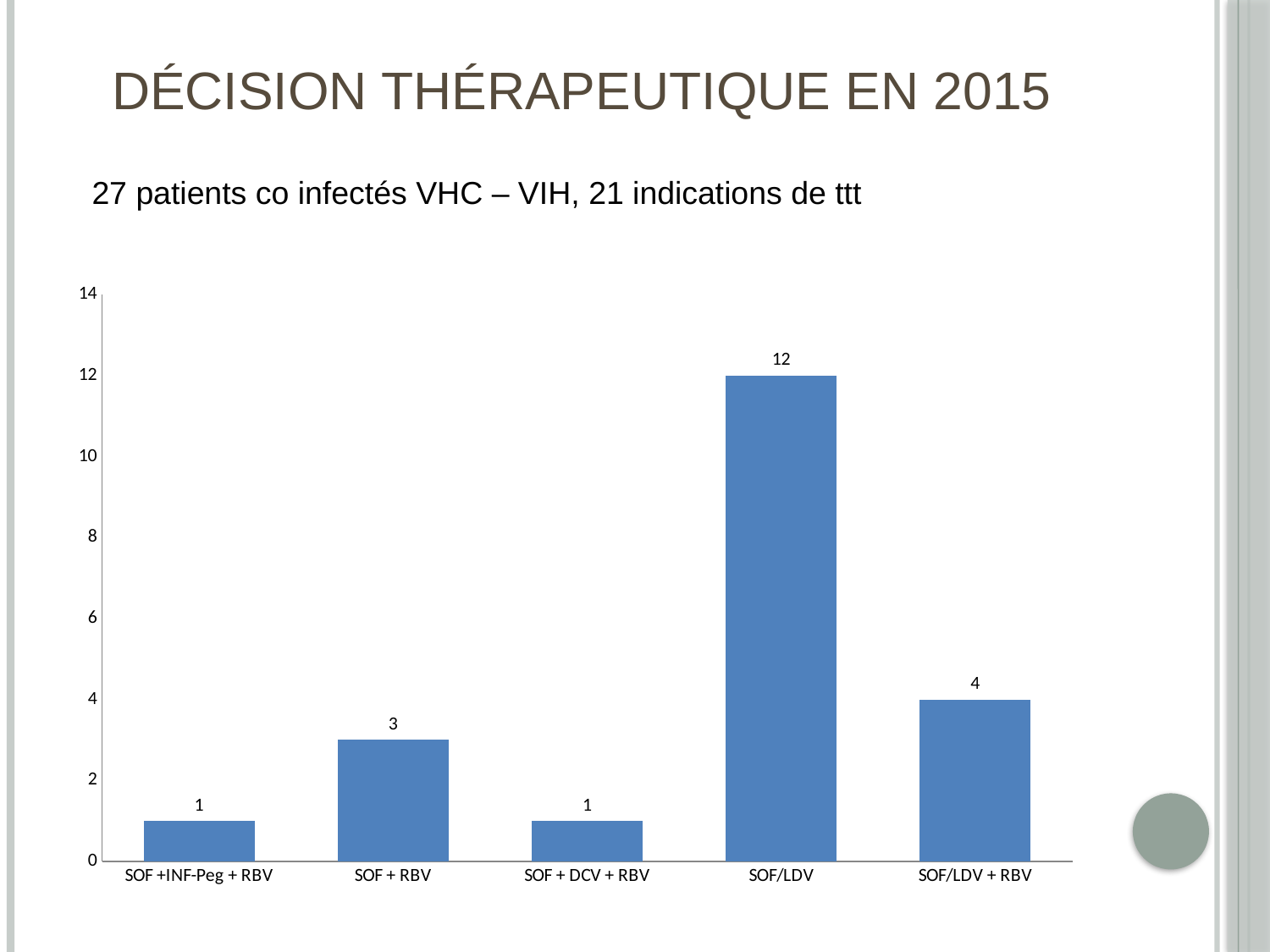
What is the value for SOF + RBV? 3 What is the title of the slide containing the chart? DÉCISION THÉRAPEUTIQUE EN 2015 Is the value for SOF/LDV greater or less than 10? greater How many categories are shown on the x axis? 5 What kind of chart is shown on the slide? bar chart Which is larger, the value for SOF + RBV or the value for SOF/LDV + RBV? SOF/LDV + RBV Which category has the highest value? SOF/LDV What is the value for SOF/LDV + RBV? 4 What is the value for SOF + DCV + RBV? 1 What is the total of all the bar values in the chart? 21 What is the value for SOF/LDV? 12 What is the difference between the values for SOF/LDV and SOF/LDV + RBV? 8